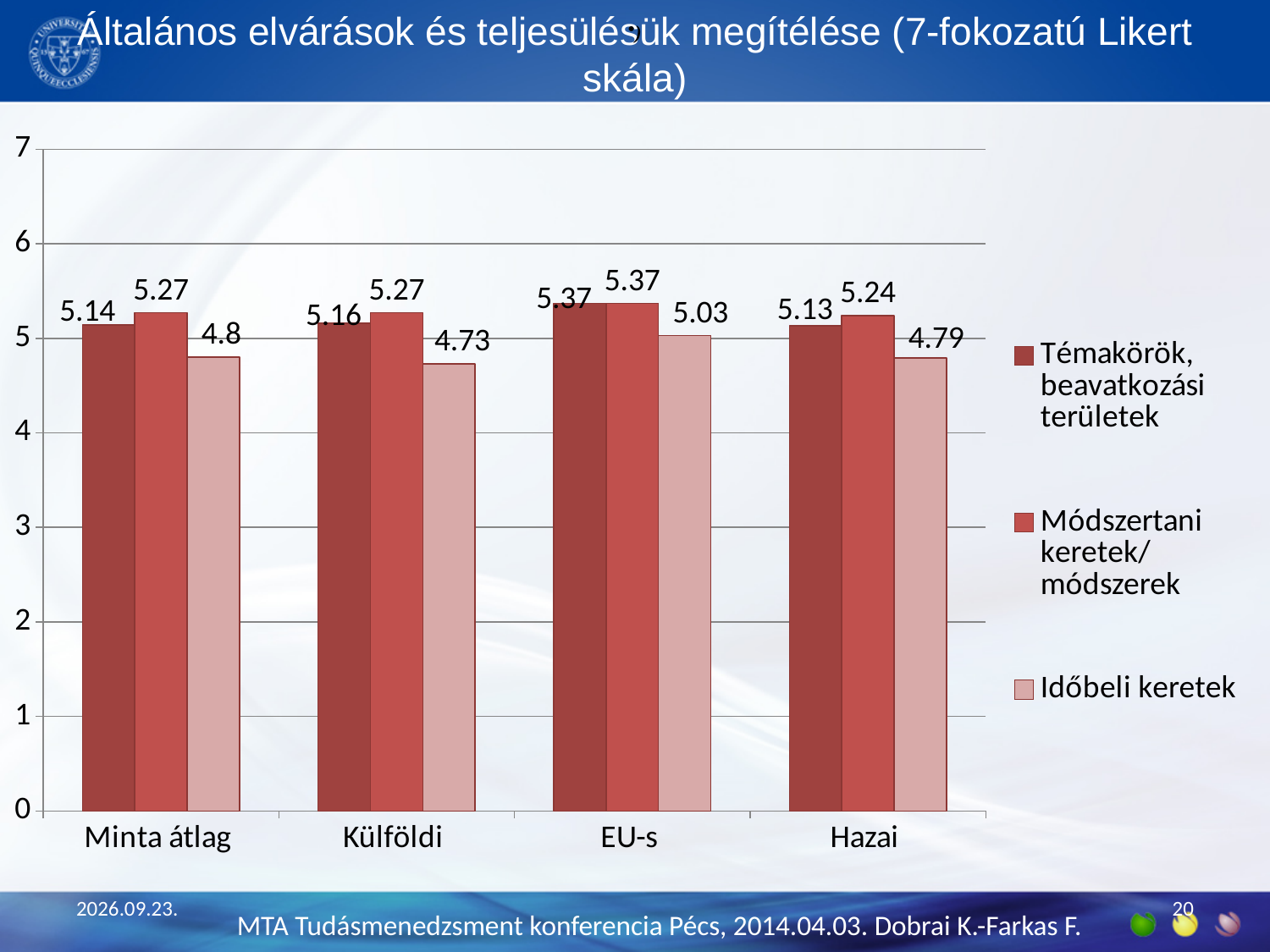
How many categories are shown on the x axis? 4 What is the value of Témakörök, beavatkozási területek for Külföldi? 5.16 What is the maximum value shown on the vertical axis? 7 What is the value of Időbeli keretek for Minta átlag? 4.8 Which category has the highest value for Időbeli keretek? EU-s What is the value of Módszertani keretek/módszerek for Hazai? 5.24 What is the difference between the Módszertani keretek/módszerek value and the Időbeli keretek value for EU-s? 0.34 How many series does the legend list? 3 What kind of chart is shown on the slide? bar chart For Hazai, which is larger: Témakörök, beavatkozási területek or Időbeli keretek? Témakörök, beavatkozási területek Is the value of Időbeli keretek for Külföldi greater or less than 5? less Which category has the lowest value for Időbeli keretek? Külföldi